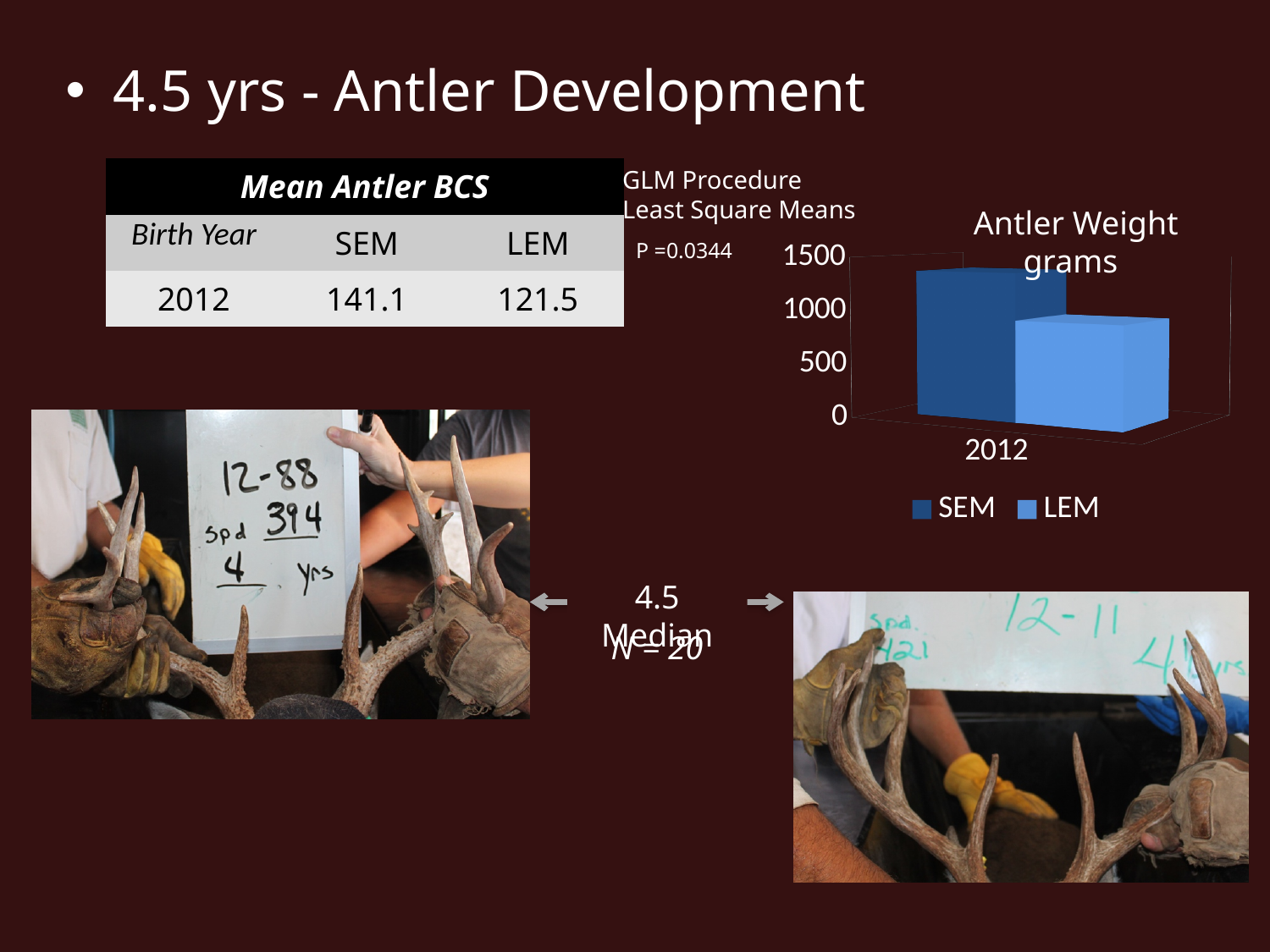
Which category label appears on the x axis of the Antler Weight chart? 2012 In the Antler Weight chart, which series has the taller bar for 2012, SEM or LEM? SEM In the Antler Weight chart, is the SEM value for 2012 greater or less than 1000? greater In the Antler Weight chart, which series has the lowest value for 2012? LEM How many series does the legend of the Antler Weight chart list? 2 In the Antler Weight chart, which series has the highest value for 2012? SEM What are the series names in the legend of the Antler Weight chart? SEM and LEM How many categories are shown on the x axis of the Antler Weight chart? 1 In the Antler Weight chart, is the SEM value for 2012 greater or less than 1500? less What kind of chart is the Antler Weight chart? bar chart In the Antler Weight chart, is the LEM value for 2012 greater or less than 500? greater